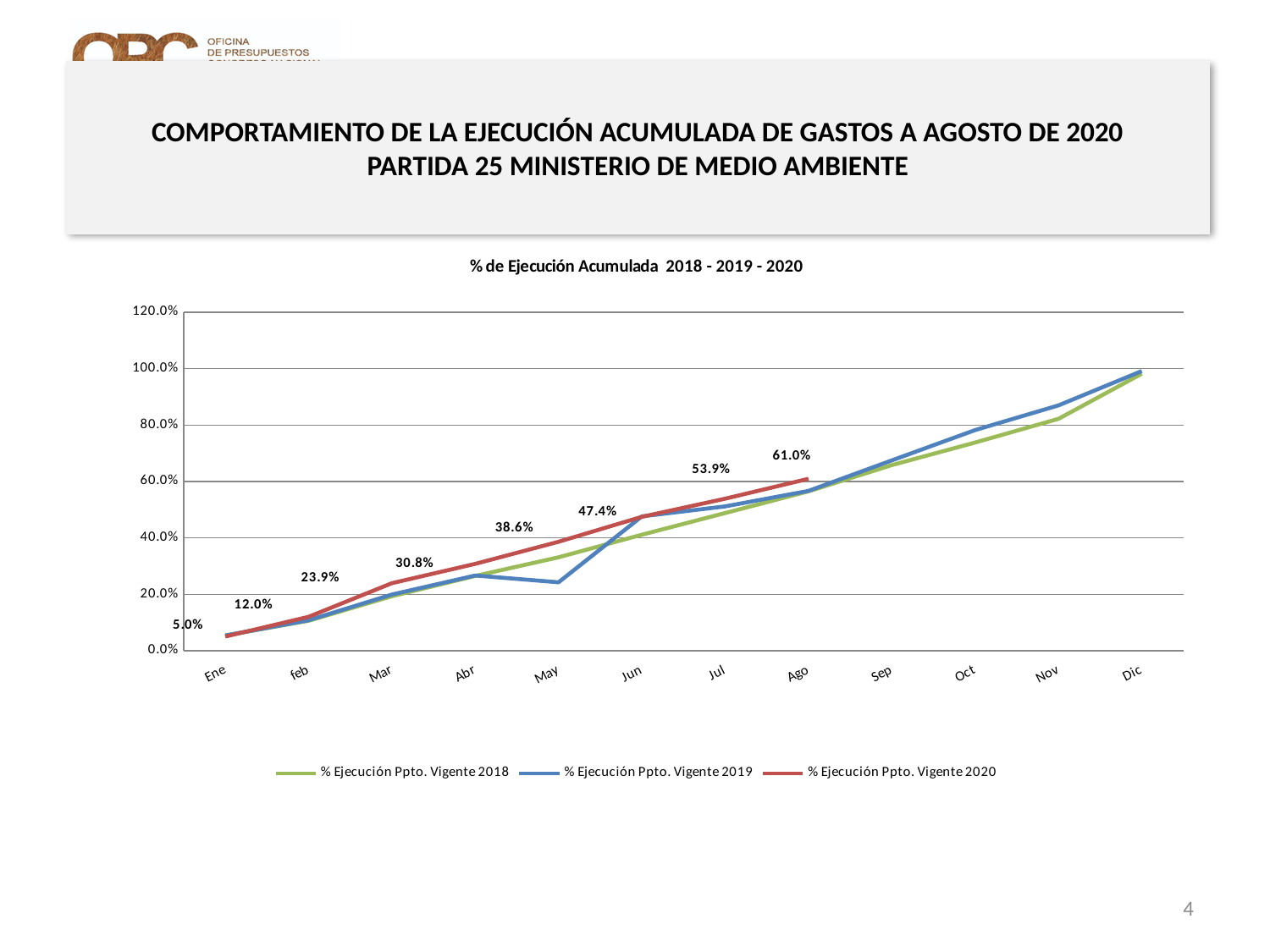
What is the difference between the 2020 values for Ago and Jul? 7.1% Does the % Ejecución Ppto. Vigente 2020 series rise or fall from Ene to Ago? rise What is the chart's title? % de Ejecución Acumulada 2018 - 2019 - 2020 How many months are shown on the x axis? 12 What is the value for % Ejecución Ppto. Vigente 2020 in Ene? 5.0% What is the value for % Ejecución Ppto. Vigente 2020 in Mar? 23.9% What is the difference between the 2020 values for Jun and Ene? 42.4% How many series does the legend list? 3 Is the value for % Ejecución Ppto. Vigente 2019 in May greater or less than 40.0%? less What is the value for % Ejecución Ppto. Vigente 2020 in Ago? 61.0% Which series is drawn in red? % Ejecución Ppto. Vigente 2020 What kind of chart is shown on the slide? line chart